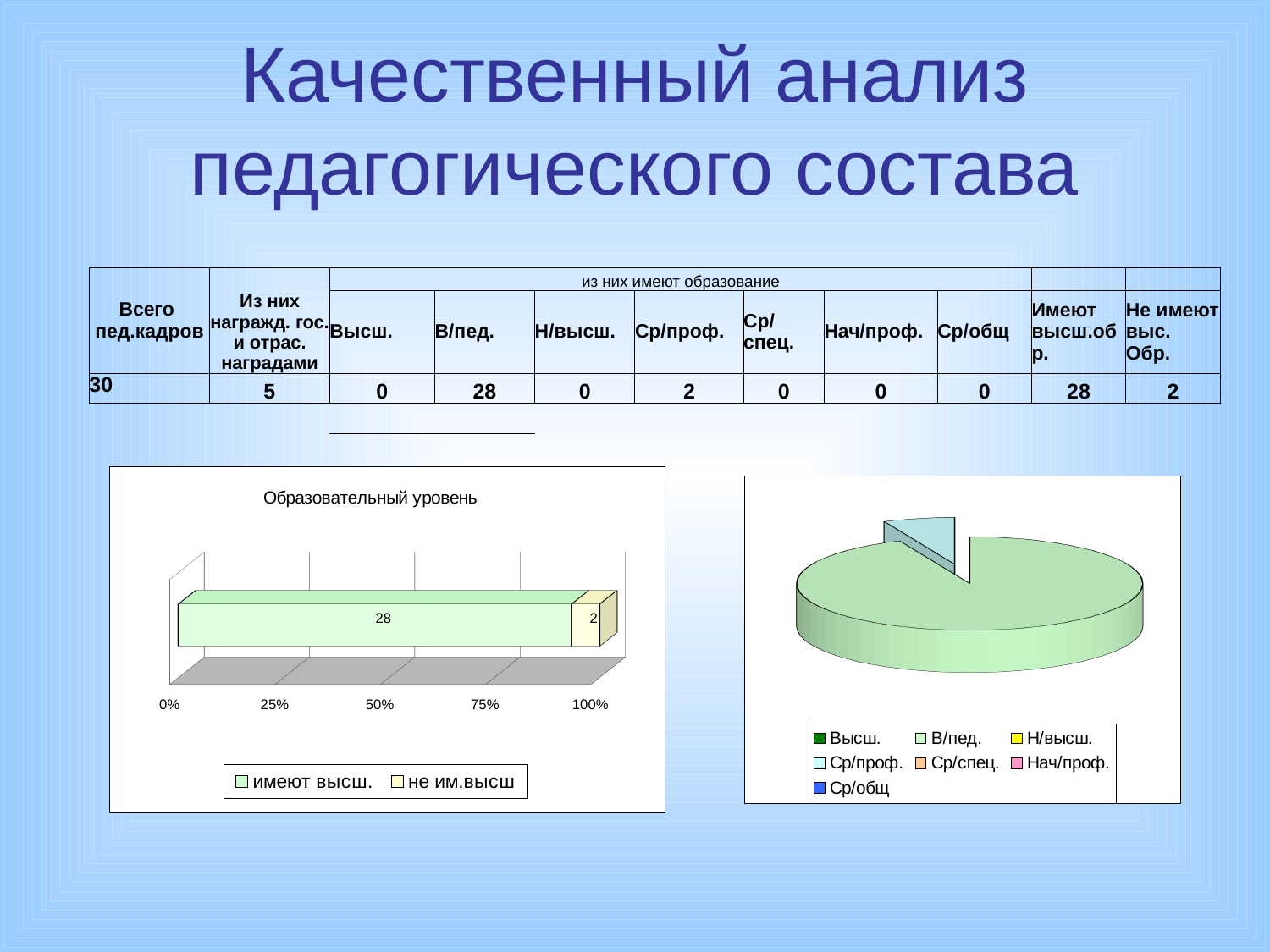
What kind of chart is the chart on the left of the slide? bar chart In the pie chart on the right, how many slices are visible? 2 How many entries does the legend of the pie chart on the right list? 7 How many series does the legend of the bar chart titled "Образовательный уровень" list? 2 In the bar chart titled "Образовательный уровень", what is the total of the stacked bar? 30 In the bar chart titled "Образовательный уровень", which is larger: "имеют высш." or "не им.высш"? имеют высш. In the bar chart titled "Образовательный уровень", what is the value for "имеют высш."? 28 In the pie chart on the right, which category has the largest slice? В/пед. In the bar chart titled "Образовательный уровень", what is the value for "не им.высш"? 2 What kind of chart is the chart on the right of the slide? pie chart In the bar chart titled "Образовательный уровень", what is the difference between the values for "имеют высш." and "не им.высш"? 26 What is the title of the chart on the left of the slide? Образовательный уровень